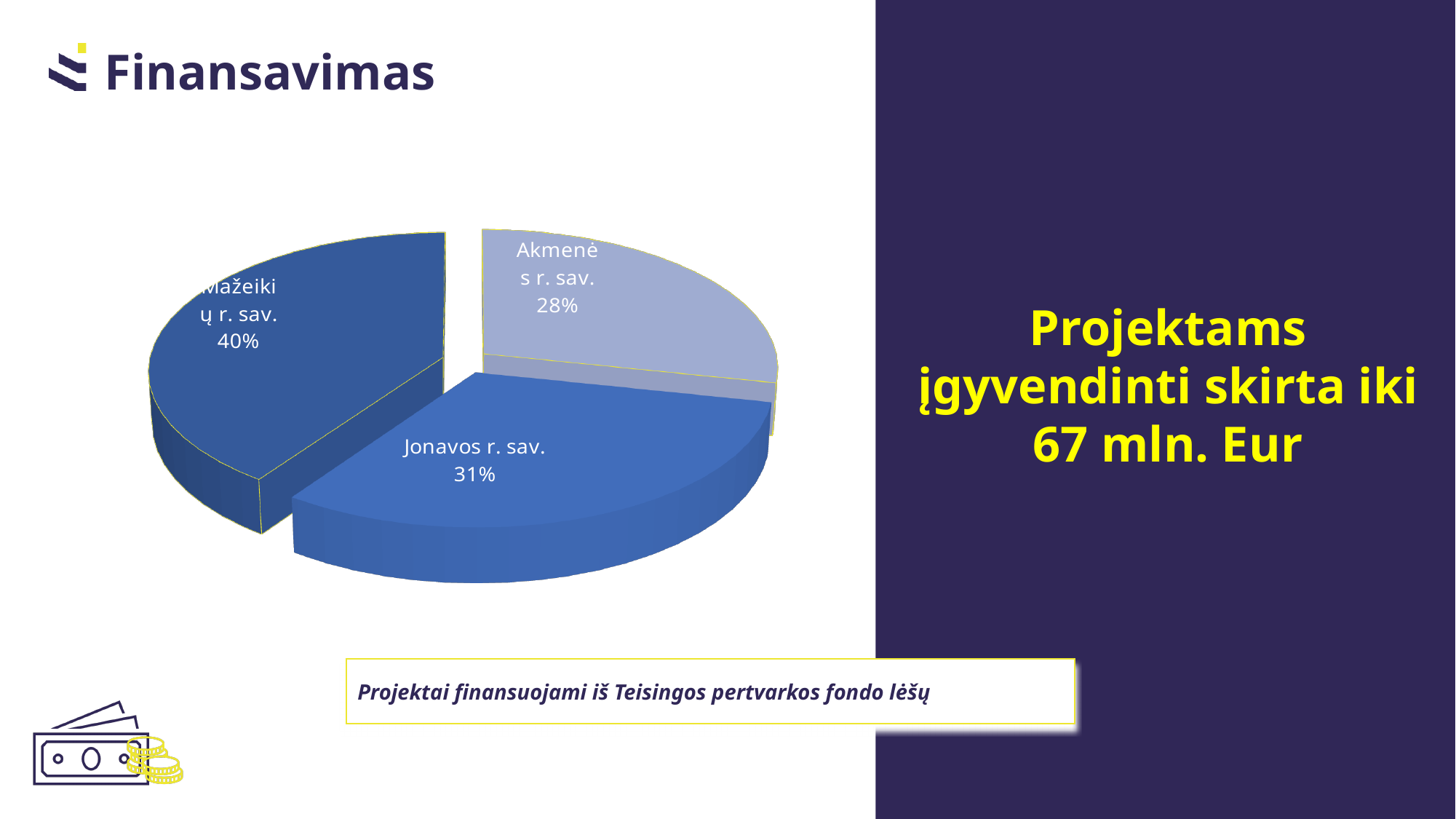
What is the heading at the top of the slide? Finansavimas What is the difference in percentage points between the Mažeikių r. sav. and Jonavos r. sav. slices? 9 What share of the pie does Jonavos r. sav. hold? 31% Which slice of the pie is the smallest? Akmenės r. sav. What share of the pie does Akmenės r. sav. hold? 28% What share of the pie does Mažeikių r. sav. hold? 40% What is the difference in percentage points between the Mažeikių r. sav. and Akmenės r. sav. slices? 12 Which is larger, the Jonavos r. sav. slice or the Akmenės r. sav. slice? Jonavos r. sav. Which slice of the pie is the largest? Mažeikių r. sav. What kind of chart is shown on the slide? Pie chart How many slices does the pie chart have? 3